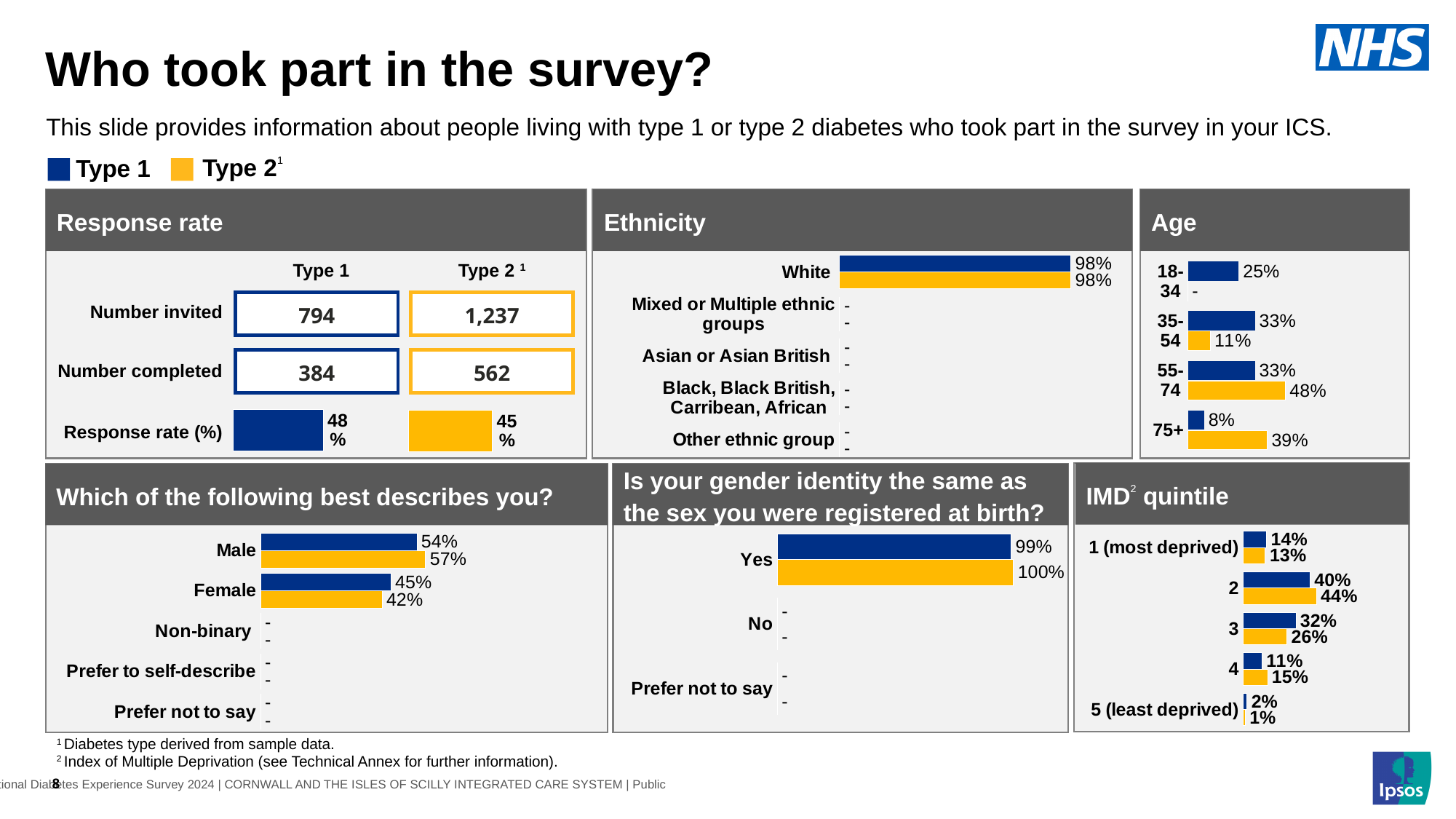
In the 'Which of the following best describes you?' chart, what is the Type 2 value for Male? 57% In the Response rate chart, what is the response rate for Type 1? 48% In the gender identity chart, what is the Type 2 value for Yes? 100% In the Ethnicity chart, what is the Type 2 value for White? 98% In the IMD quintile chart, which quintile has the highest Type 1 value? 2 In the Age chart, which age group has the highest Type 2 value? 55-74 How many series does the legend at the top of the slide list? 2 In the Response rate chart, which has the higher response rate, Type 1 or Type 2? Type 1 In the Age chart, what is the Type 2 value for 55-74? 48% In the 'Which of the following best describes you?' chart, what is the difference between the Type 1 values for Male and Female? 9% In the Age chart, what is the difference between the Type 1 and Type 2 values for 75+? 31% In the IMD quintile chart, which quintile has the lowest Type 2 value? 5 (least deprived)